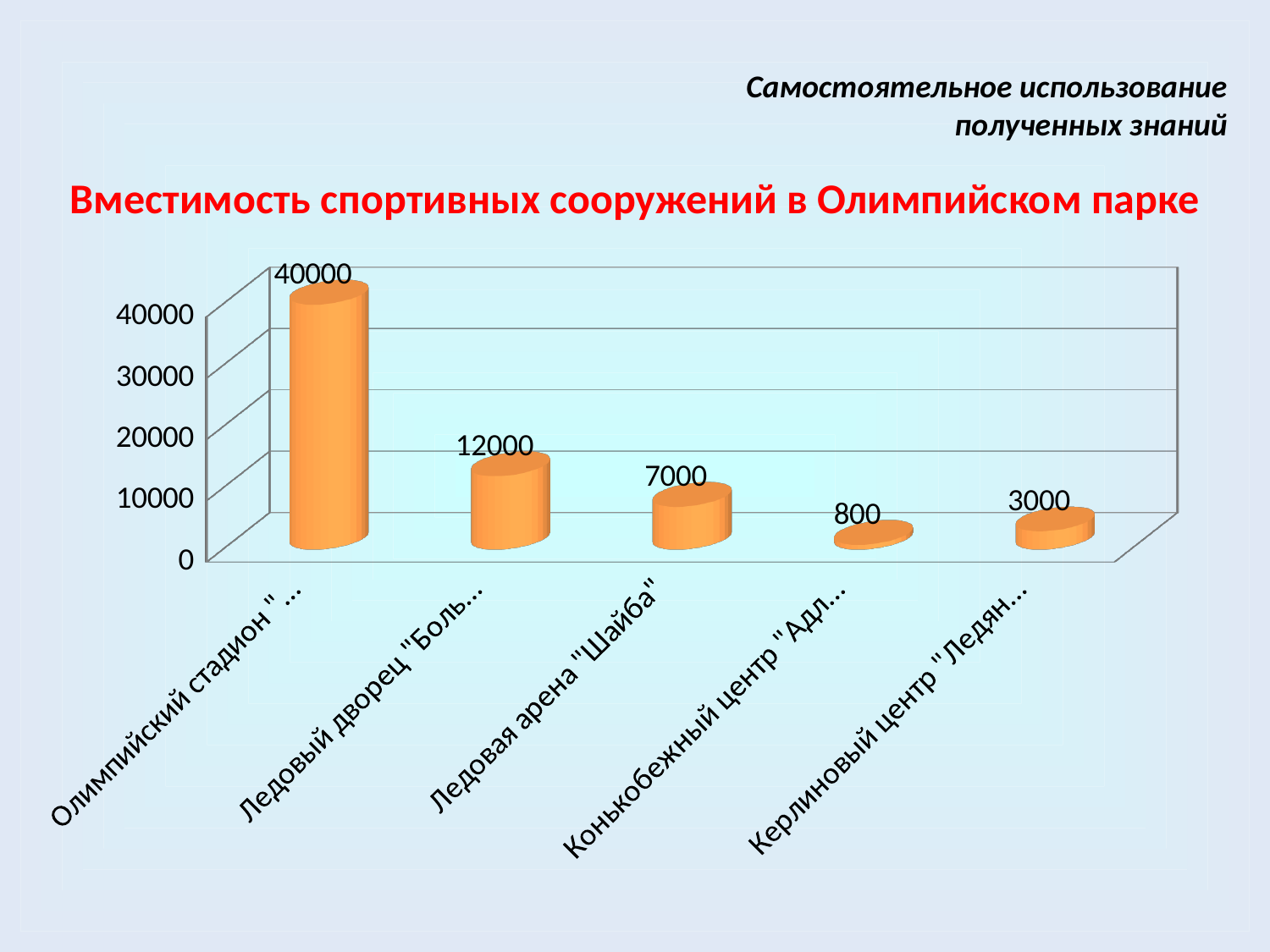
What is the value shown for Ледовая арена "Шайба"? 7000 What is the value shown for the Конькобежный центр bar? 800 What is the value shown for the Ледовый дворец bar? 12000 What is the difference between the values for Олимпийский стадион and Ледовый дворец? 28000 What is the value shown for the Олимпийский стадион bar? 40000 Which category has the lowest value? Конькобежный центр What kind of chart is shown on the slide? Bar chart What is the title of the chart? Вместимость спортивных сооружений в Олимпийском парке What is the value shown for the Керлиновый центр bar? 3000 Which is larger, the value for Ледовая арена "Шайба" or the value for Керлиновый центр? Ледовая арена "Шайба" How many categories are plotted in the chart? 5 Which category has the highest value? Олимпийский стадион